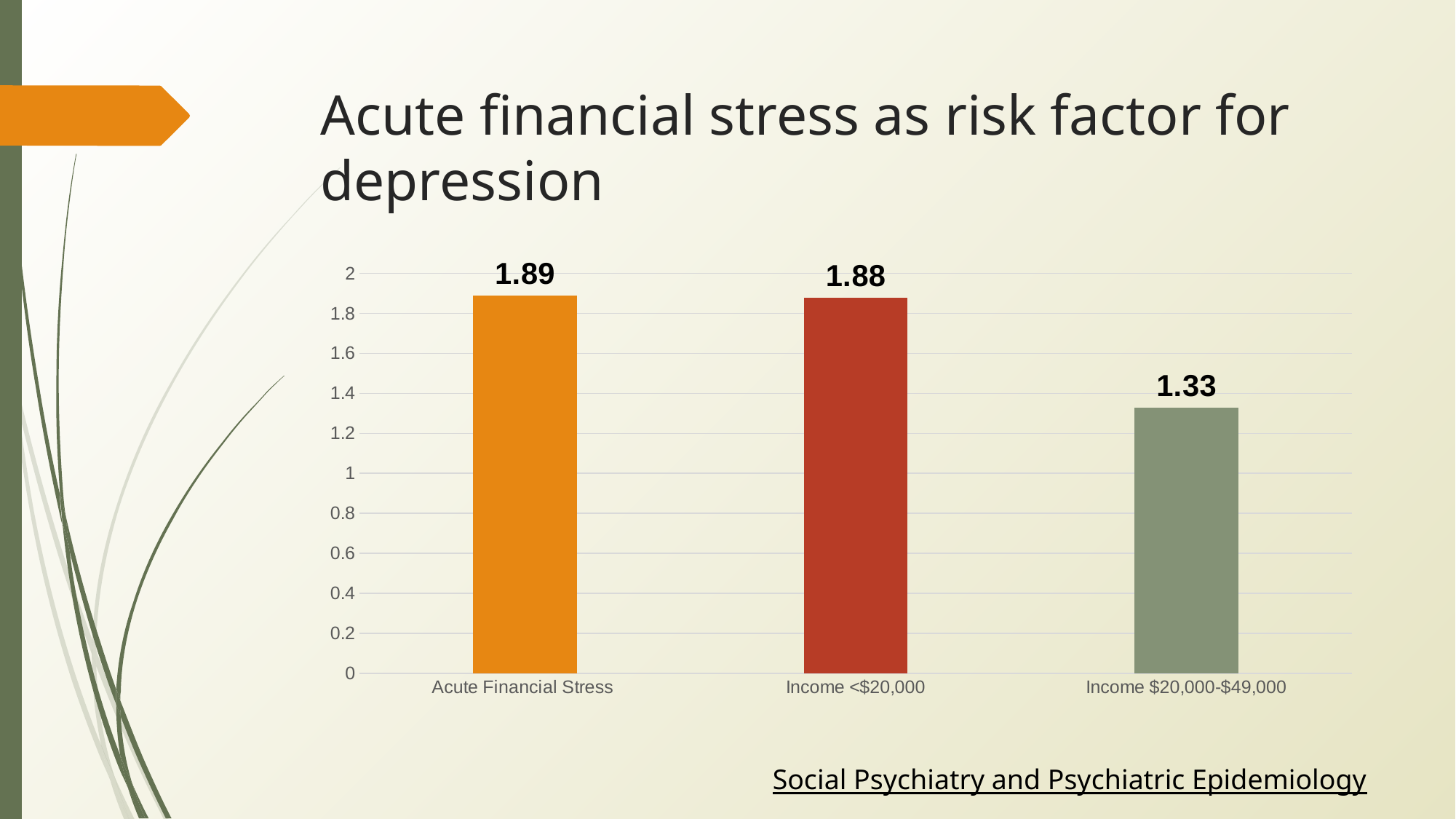
What is the value for Acute Financial Stress? 1.89 What is the value for Income $20,000-$49,000? 1.33 How many categories are shown in the chart? 3 Is the value for Acute Financial Stress greater or less than 1.8? greater What kind of chart is shown on the slide? bar chart Which is larger, the value for Income <$20,000 or the value for Income $20,000-$49,000? Income <$20,000 Which category has the lowest value? Income $20,000-$49,000 What is the difference between the values for Income <$20,000 and Income $20,000-$49,000? 0.55 What is the difference between the values for Acute Financial Stress and Income $20,000-$49,000? 0.56 What is the value for Income <$20,000? 1.88 Is the value for Income $20,000-$49,000 greater or less than 1.4? less What colour is the bar for Acute Financial Stress? orange